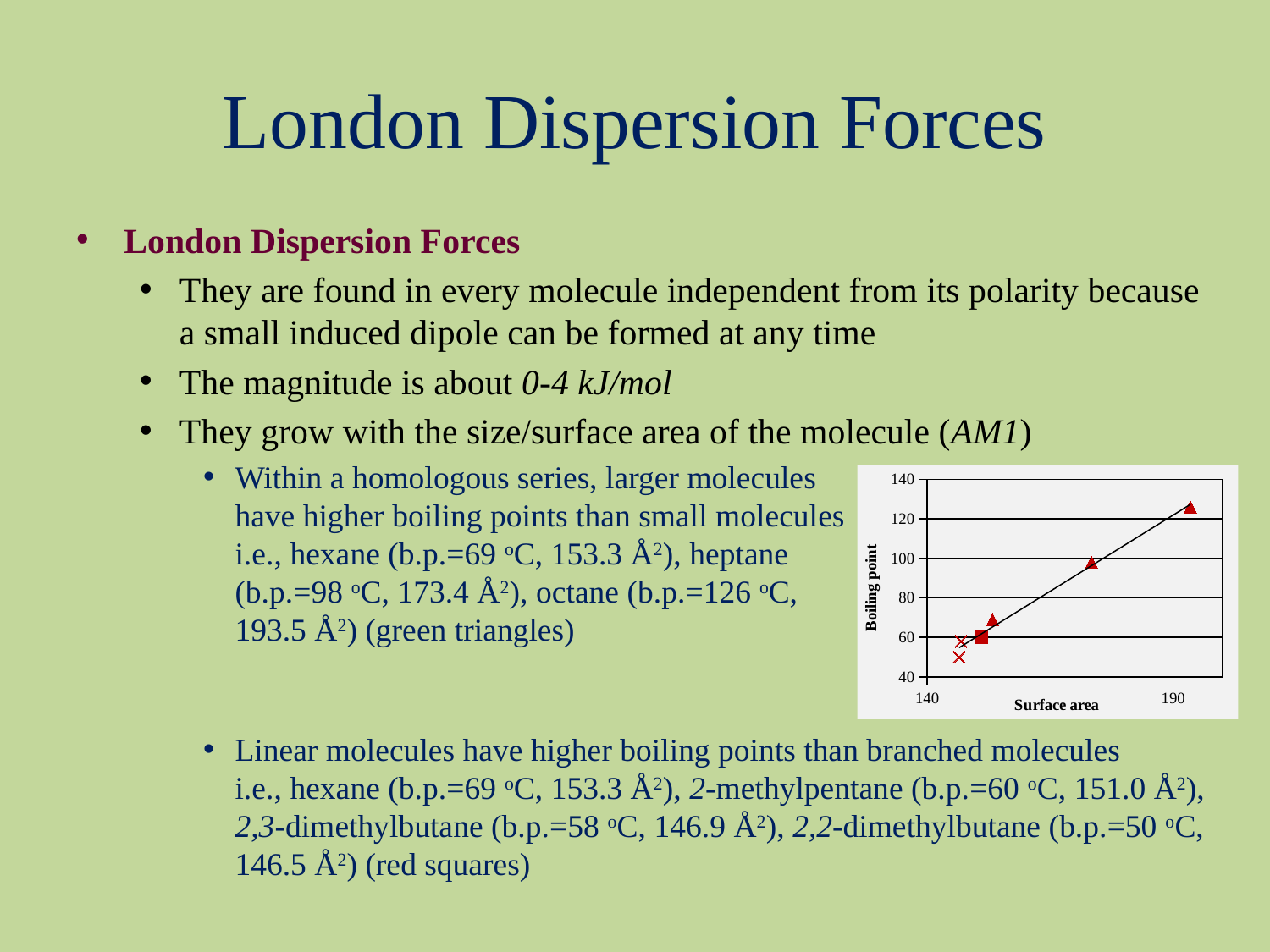
Which marker type in the chart reaches the highest boiling point: triangles, squares or crosses? triangles What is the title of the x axis of the chart? Surface area Which has the higher boiling point in the chart, the highest triangle marker or the square marker? the highest triangle marker Is the boiling point of the middle triangle marker in the chart greater or less than 80? greater What kind of chart is shown on the slide? scatter chart In the chart, does boiling point rise or fall as surface area increases along the x axis? rise How many triangle markers are plotted in the chart? 3 Is the surface area of the highest triangle marker in the chart greater or less than 190? greater What is the title of the y axis of the chart? Boiling point Is the boiling point of the highest triangle marker in the chart greater or less than 120? greater